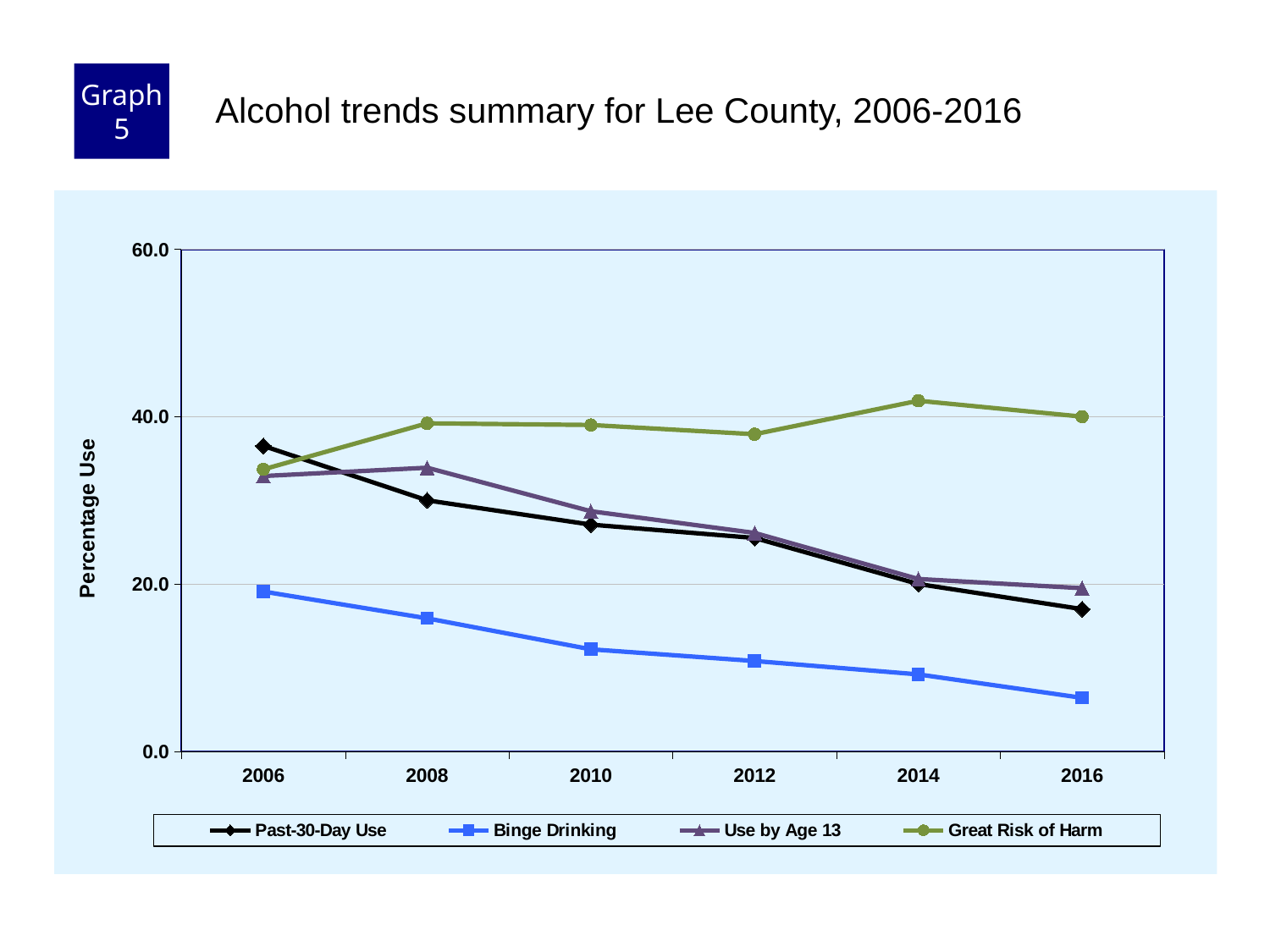
Is the value for Binge Drinking in 2006 greater or less than 20.0? less What kind of chart is shown on the slide? line chart How many years are plotted along the x axis? 6 What is the label on the y axis? Percentage Use Does the Binge Drinking series rise or fall from 2006 to 2016? fall Which series has the lowest value in 2016? Binge Drinking How many series does the legend list? 4 Is the value for Past-30-Day Use in 2008 greater or less than 40.0? less Is the value for Great Risk of Harm in 2014 greater or less than 40.0? greater In 2006, which is larger: Past-30-Day Use or Binge Drinking? Past-30-Day Use Which series has the highest value in 2014? Great Risk of Harm Does the Past-30-Day Use series rise or fall from 2006 to 2016? fall